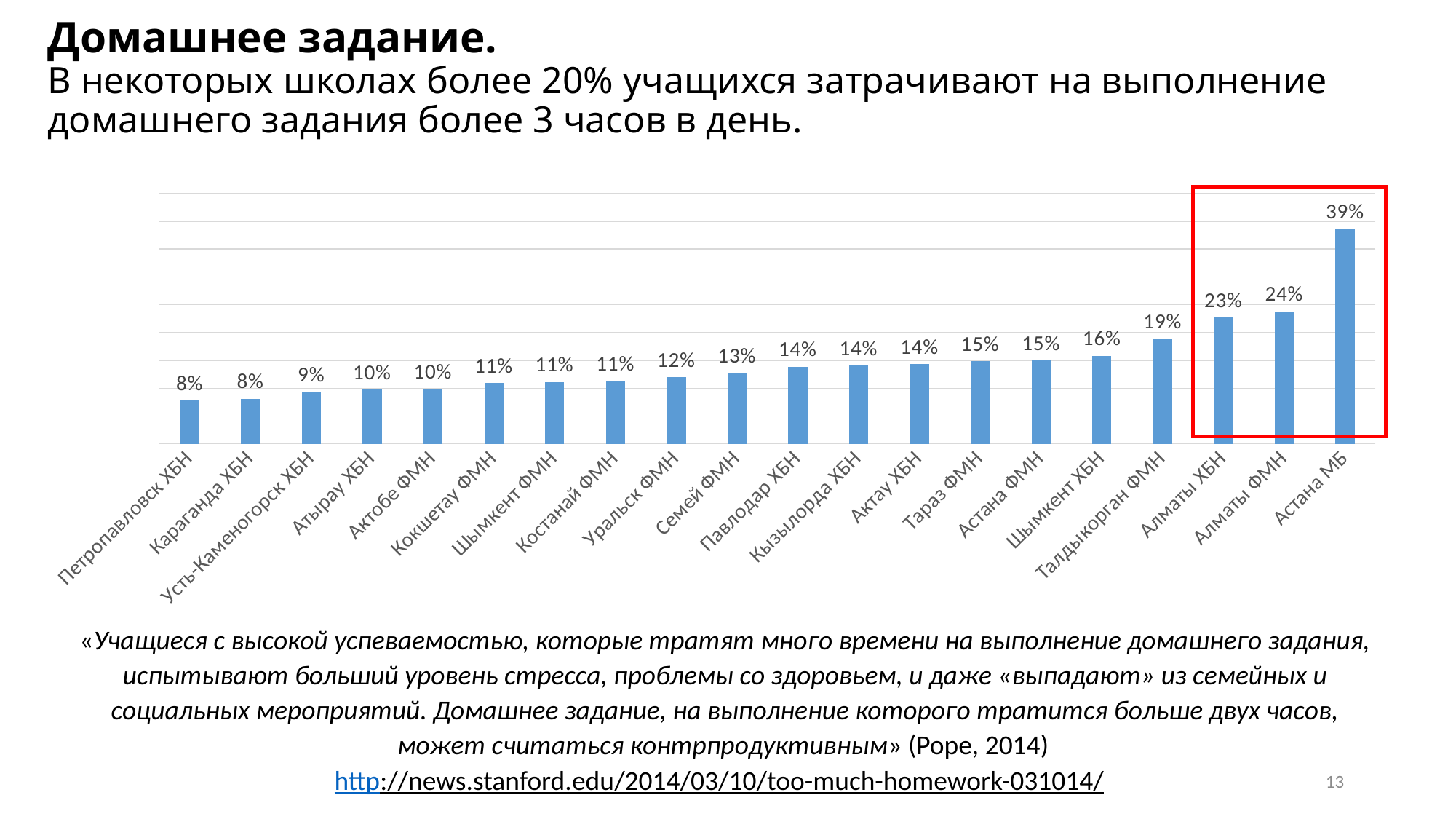
What kind of chart is shown on the slide? Bar chart Which category has the highest value? Астана МБ What is the value for Шымкент ХБН? 16% What is the value for Астана МБ? 39% What is the difference between the values for Астана МБ and Алматы ФМН? 15% How many categories are shown on the chart? 20 What is the difference between the values for Алматы ХБН and Талдыкорган ФМН? 4% What is the value for Талдыкорган ФМН? 19% Do the values generally rise or fall from left to right along the x axis? Rise Which is larger, the value for Семей ФМН or the value for Уральск ФМН? Семей ФМН How many bars are enclosed by the red rectangle on the chart? 3 What is the value for Усть-Каменогорск ХБН? 9%